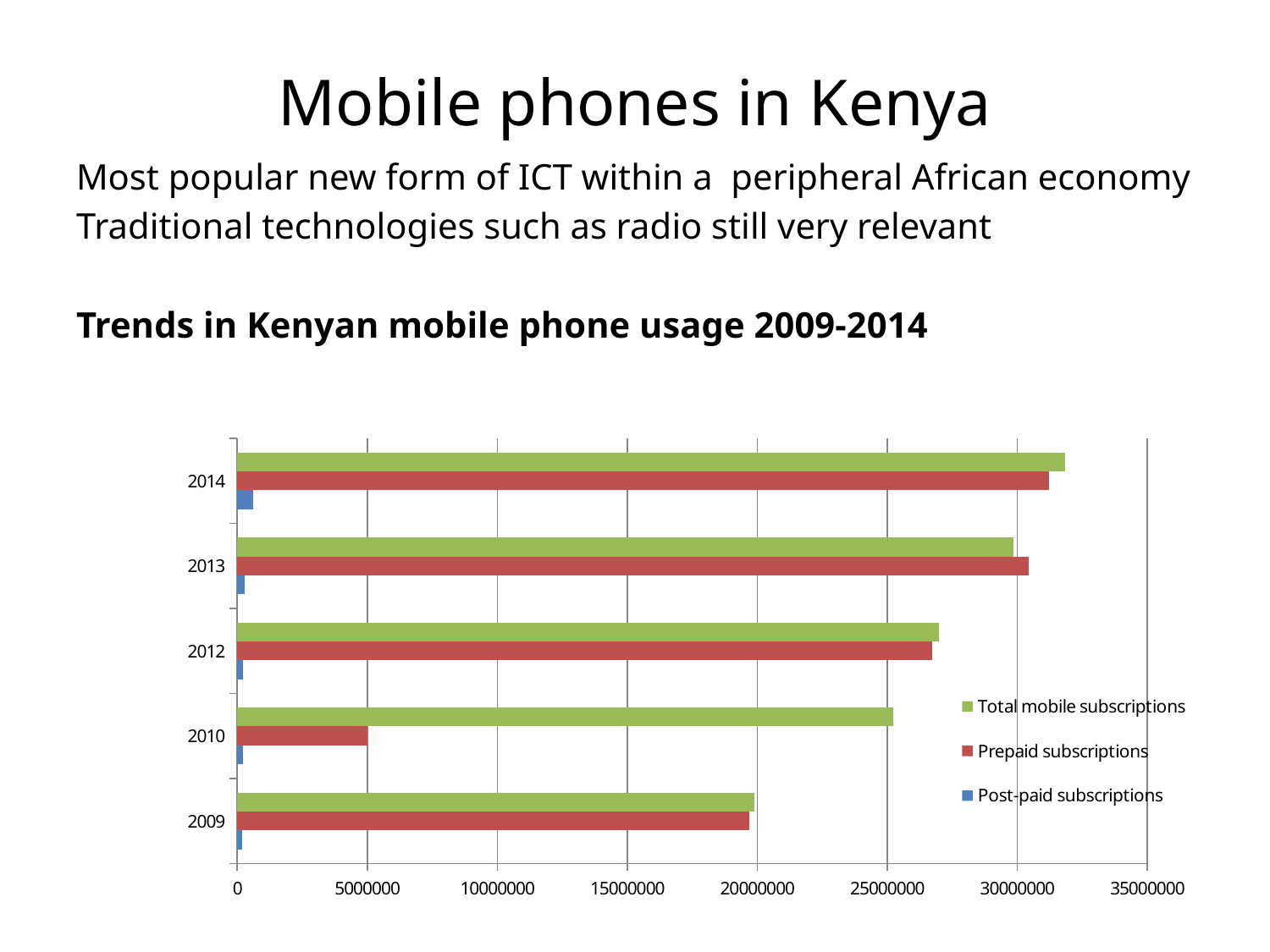
Which year has the lowest value for Total mobile subscriptions? 2009 Is the value for Post-paid subscriptions in 2014 greater or less than 5000000? less Which colour represents Prepaid subscriptions in the chart's legend? red What kind of chart is shown on the slide? bar chart How many years are shown on the chart's vertical axis? 5 Do Total mobile subscriptions rise or fall from 2009 to 2014? rise Which year has the lowest value for Prepaid subscriptions? 2010 How many series does the chart's legend list? 3 In 2010, which is larger: Total mobile subscriptions or Prepaid subscriptions? Total mobile subscriptions Which year has the highest value for Total mobile subscriptions? 2014 Is the value for Total mobile subscriptions in 2014 greater or less than 30000000? greater Is the value for Total mobile subscriptions in 2012 greater or less than 25000000? greater